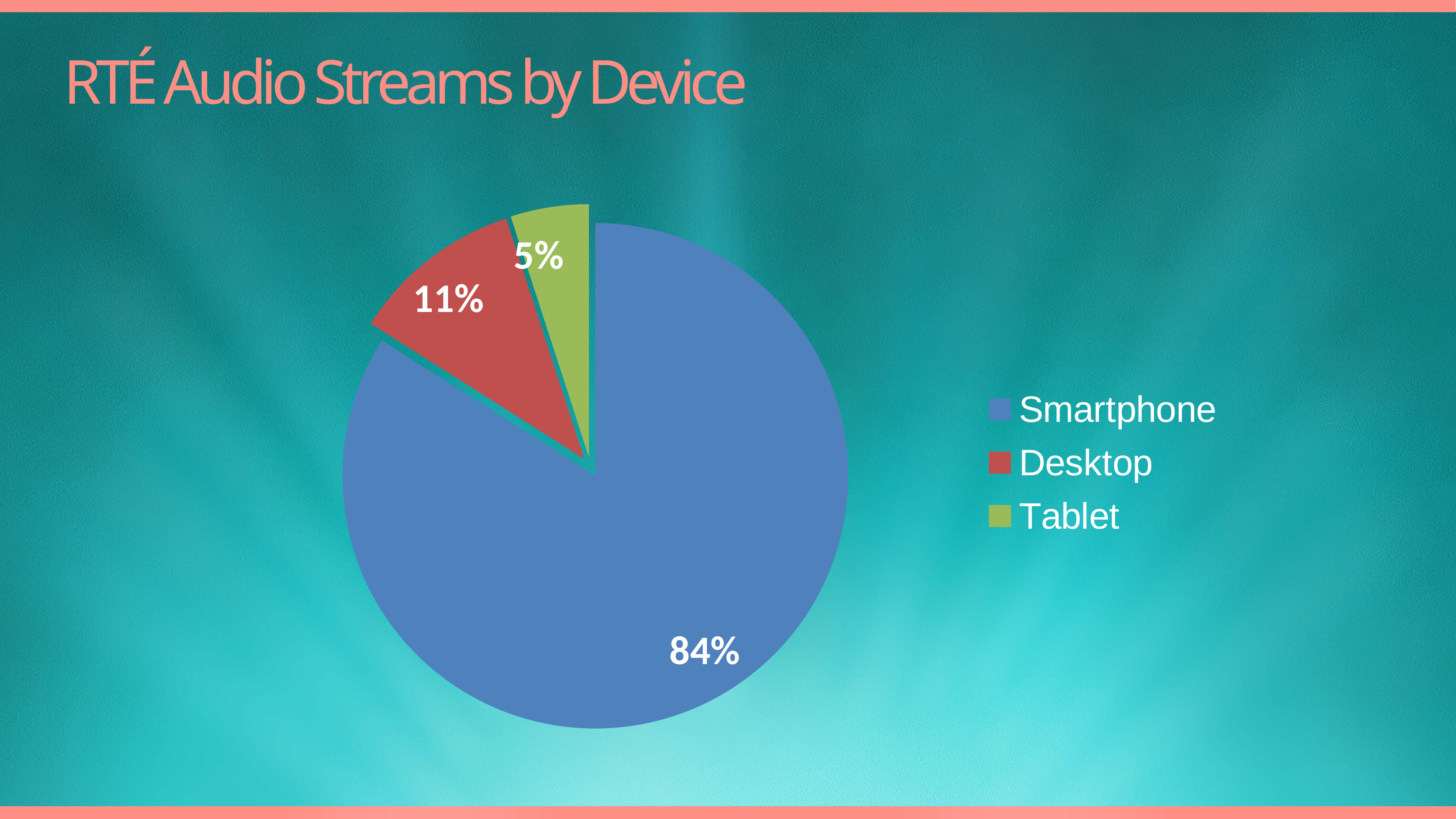
What is the difference in percentage points between the Smartphone and Desktop shares? 73 What kind of chart is shown on the slide? pie chart What share of RTÉ audio streams comes from Desktop? 11% What share of RTÉ audio streams comes from Tablet? 5% Which colour represents Tablet in the pie chart? green Which device has the smallest share of audio streams? Tablet Which has a larger share, Desktop or Tablet? Desktop What is the difference in percentage points between the Desktop and Tablet shares? 6 What is the title of the chart? RTÉ Audio Streams by Device How many device categories does the pie chart show? 3 Which device has the largest share of audio streams? Smartphone What share of RTÉ audio streams comes from Smartphone? 84%